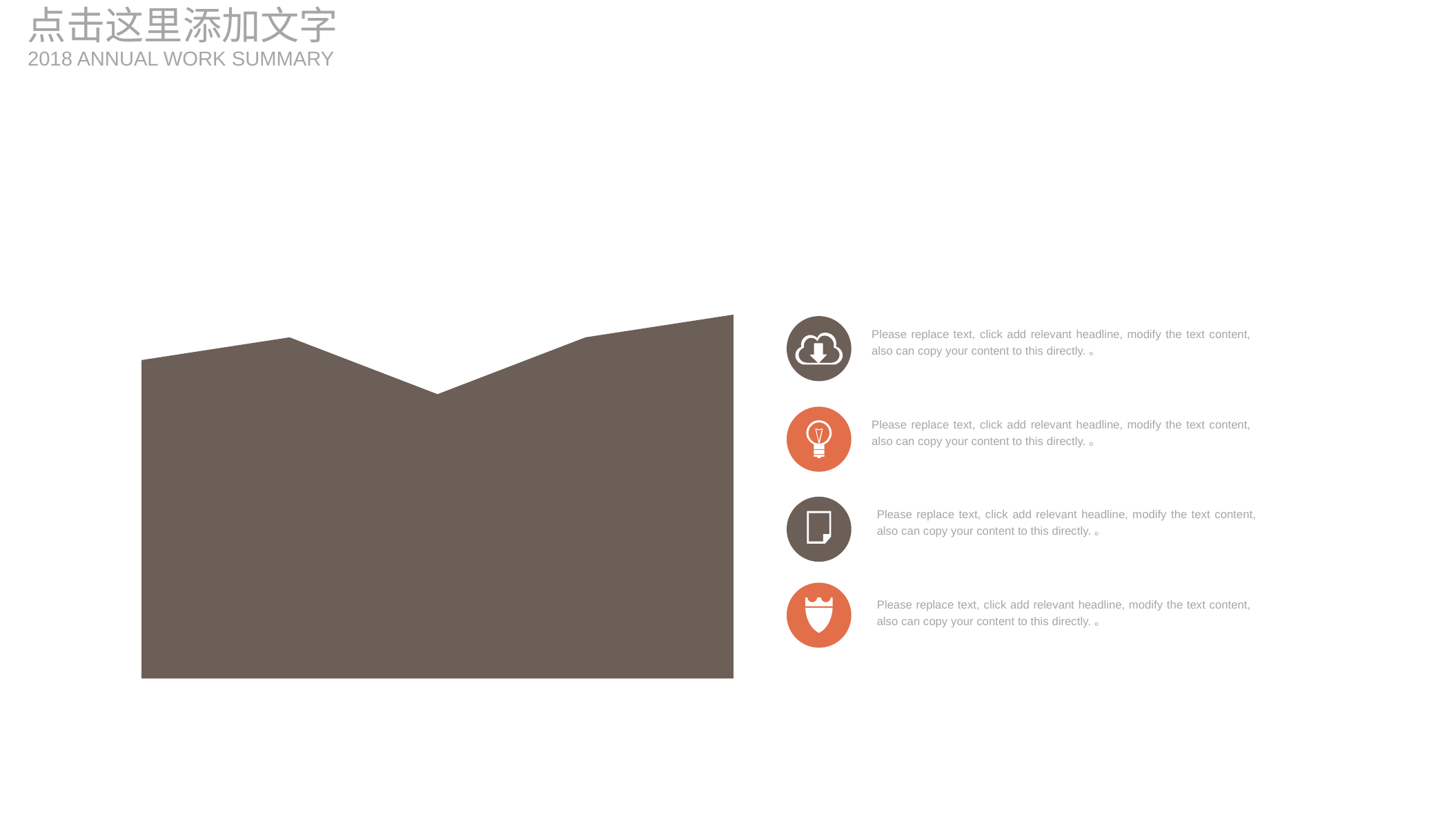
Is the value at the right end of the area chart higher or lower than the value at the left end? higher Does the area chart rise or fall over its final segment on the right? rise Where along the x axis does the area chart reach its highest point: near the left, in the middle, or near the right? near the right What colour is the filled area in the chart? brown Does the chart display a legend? no Where along the x axis does the area chart reach its lowest point: near the left, in the middle, or near the right? in the middle What kind of chart is shown on the left of the slide? area chart